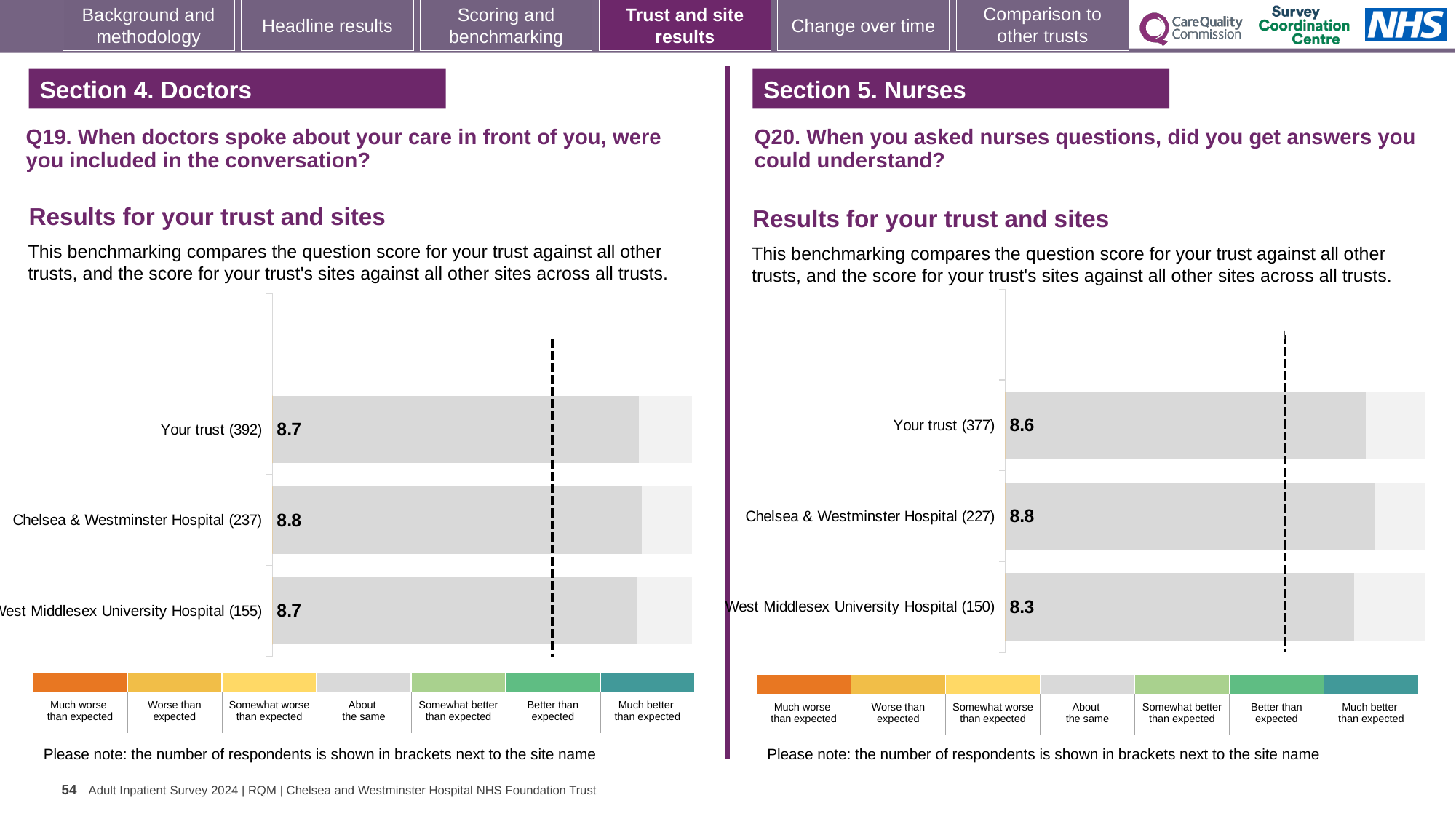
In the Q19 chart on the left, what is the score for Your trust (392)? 8.7 In the Q20 chart on the right, what is the score for Your trust (377)? 8.6 In the Q19 chart on the left, which has the larger score: Chelsea & Westminster Hospital (237) or West Middlesex University Hospital (155)? Chelsea & Westminster Hospital (237) What kind of chart is used for the Q19 results on the left? Bar chart In the Q20 chart on the right, what is the score for West Middlesex University Hospital (150)? 8.3 In the Q20 chart on the right, which site or trust has the highest score? Chelsea & Westminster Hospital (227) In the Q19 chart on the left, what is the score for Chelsea & Westminster Hospital (237)? 8.8 In the Q19 chart on the left, which site or trust has the highest score? Chelsea & Westminster Hospital (237) In the Q20 chart on the right, what is the difference between the scores for Chelsea & Westminster Hospital (227) and West Middlesex University Hospital (150)? 0.5 How many categories does the colour key below the Q19 chart on the left list? 7 How many bars are plotted in the Q20 chart on the right? 3 In the Q20 chart on the right, which site or trust has the lowest score? West Middlesex University Hospital (150)